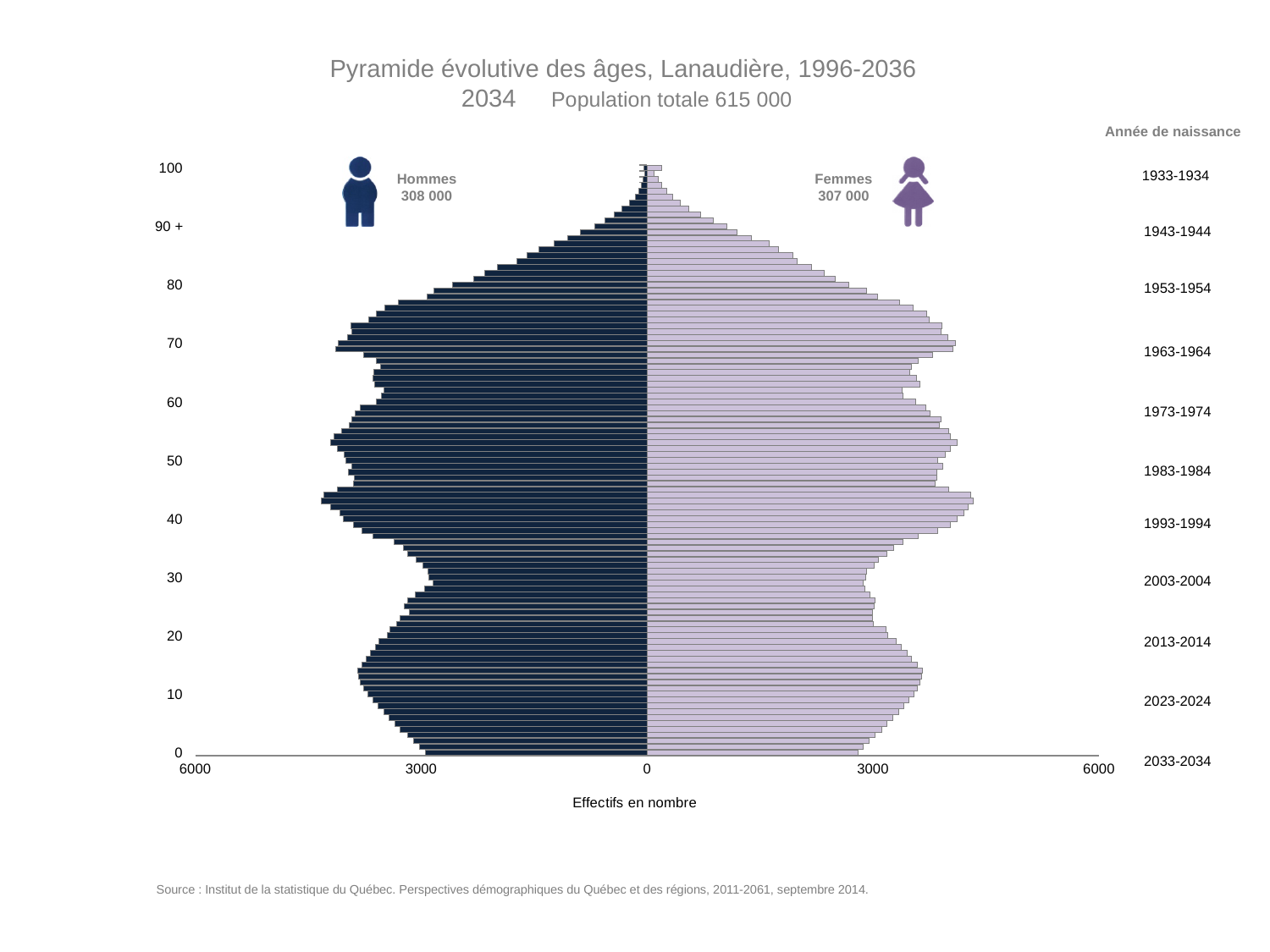
What kind of chart is shown on the slide? bar chart What is the difference between the number of Hommes and the number of Femmes? 1 000 What is the number of Femmes shown on the chart? 307 000 Is the value for Femmes at age 80 greater or less than 3000? less Which year does this population pyramid represent? 2034 What is the number of Hommes shown on the chart? 308 000 Is the value for Hommes at age 45 greater or less than 3000? greater What is the total population shown for Lanaudière in 2034? 615 000 Is the value for Hommes at age 90 greater or less than 3000? less What is the label of the horizontal axis? Effectifs en nombre How many series (population groups) does the chart show? 2 Which group is larger, Hommes or Femmes? Hommes